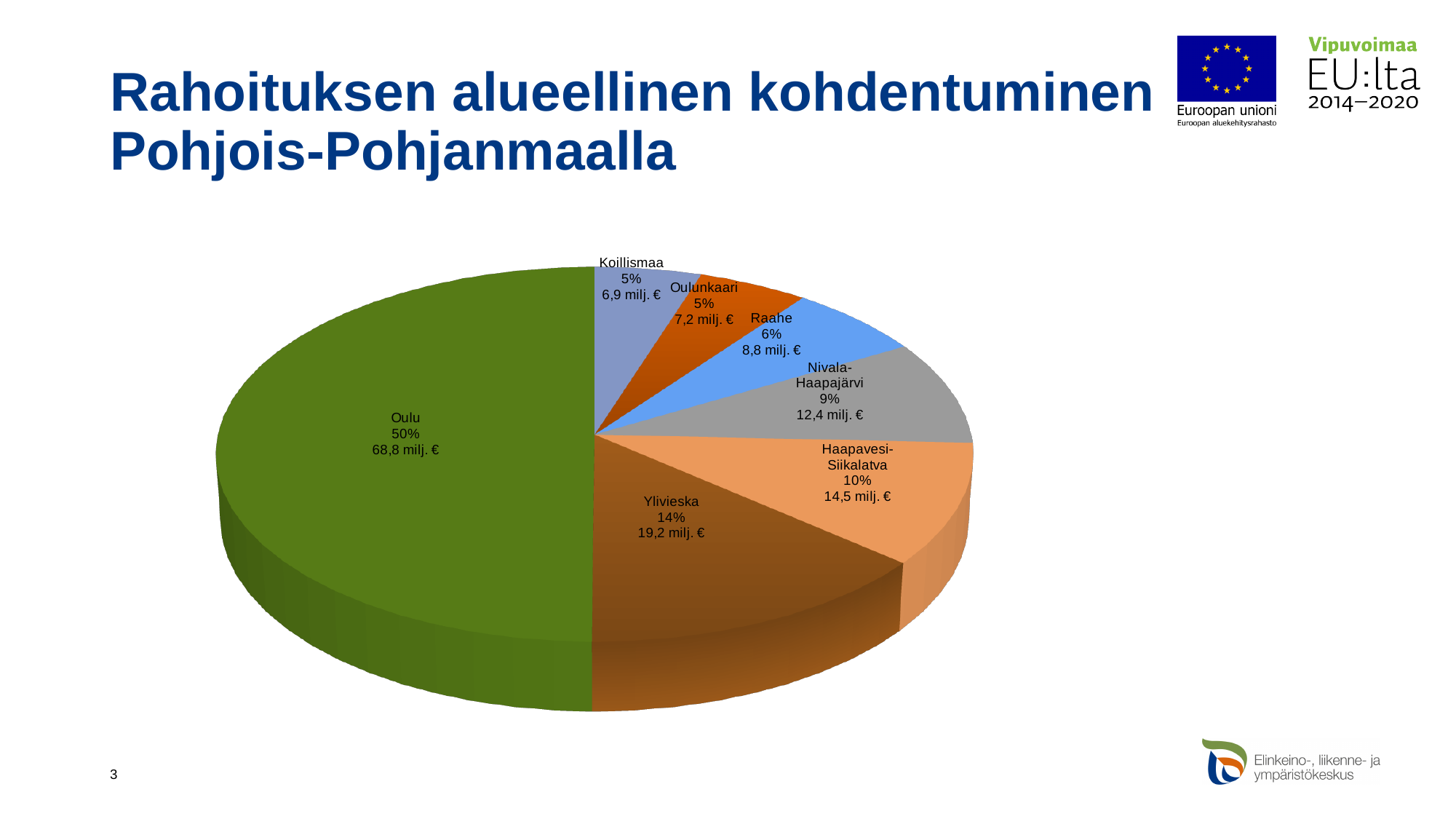
What is the funding amount shown for Nivala-Haapajärvi? 12,4 milj. € How many regions (slices) does the pie chart show? 7 Which region receives more funding, Raahe or Oulunkaari? Raahe What is the difference in funding between Oulu and Ylivieska in milj. €? 49,6 milj. € What is the funding amount shown for Ylivieska? 19,2 milj. € Which region has the smallest funding amount in milj. €? Koillismaa What share of the funding does Oulu receive? 50% What is the title of the slide containing the chart? Rahoituksen alueellinen kohdentuminen Pohjois-Pohjanmaalla What kind of chart is shown on the slide? pie chart What is the funding amount shown for Koillismaa? 6,9 milj. € Which region has the largest share of the funding? Oulu What percentage share is shown for Haapavesi-Siikalatva? 10%